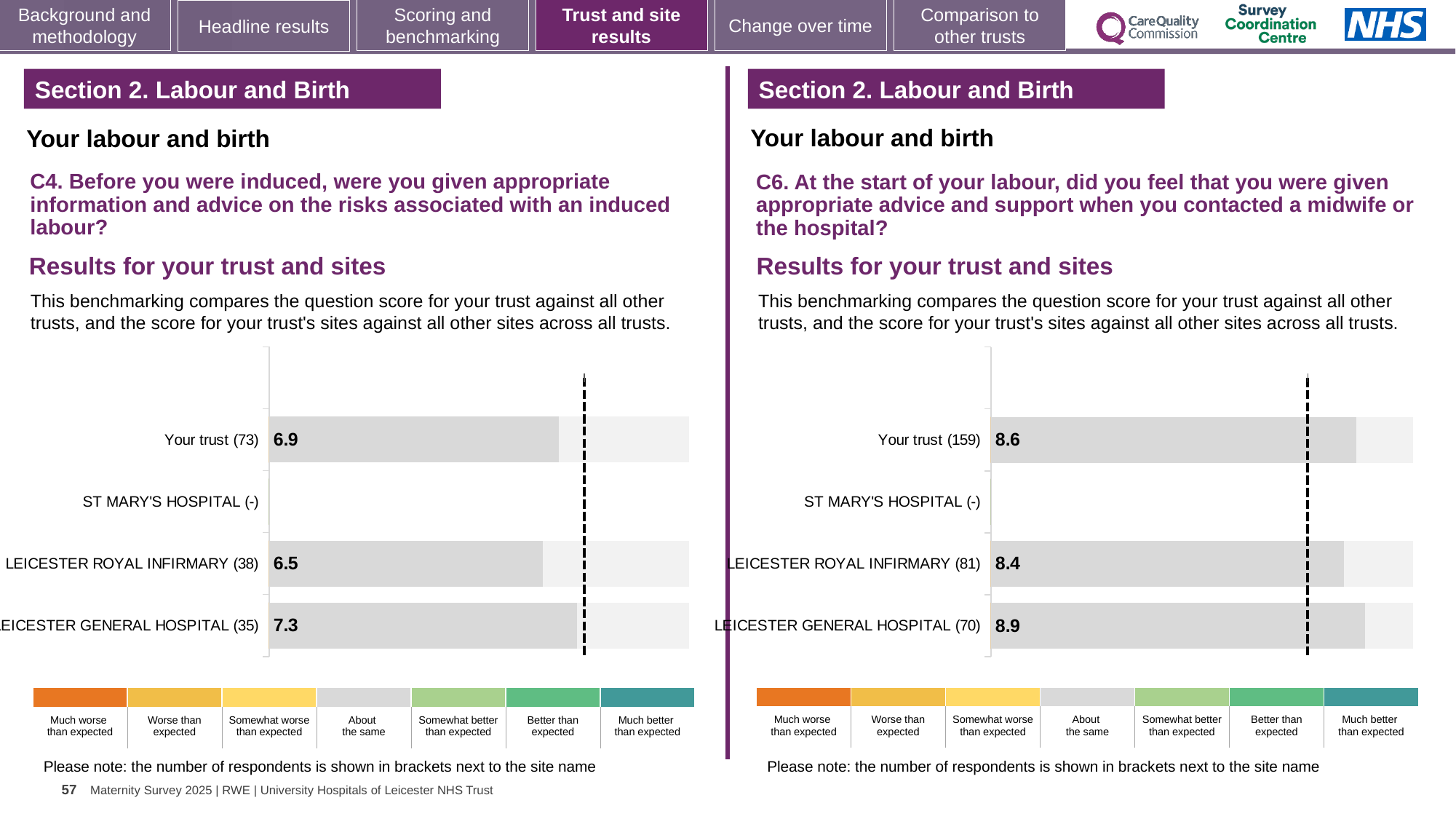
In the left chart (C4), which site has the highest score? Leicester General Hospital In the right chart (C6), which site has the lowest score among those with a plotted value? Leicester Royal Infirmary In the right chart (C6), what is the score for Your trust? 8.6 In the right chart (C6), what is the score for Leicester General Hospital? 8.9 In the right chart (C6), what is the score for Leicester Royal Infirmary? 8.4 In the left chart (C4), what is the score for Your trust? 6.9 In the left chart (C4), what is the score for Leicester Royal Infirmary? 6.5 In the right chart (C6), how many respondents are shown in brackets for Your trust? 159 In the left chart (C4), what is the difference between the scores for Leicester General Hospital and Leicester Royal Infirmary? 0.8 In the left chart (C4), what is the score for Leicester General Hospital? 7.3 What kind of chart is used on the left (C4)? Bar chart In the right chart (C6), which is larger, the score for Your trust or for Leicester General Hospital? Leicester General Hospital